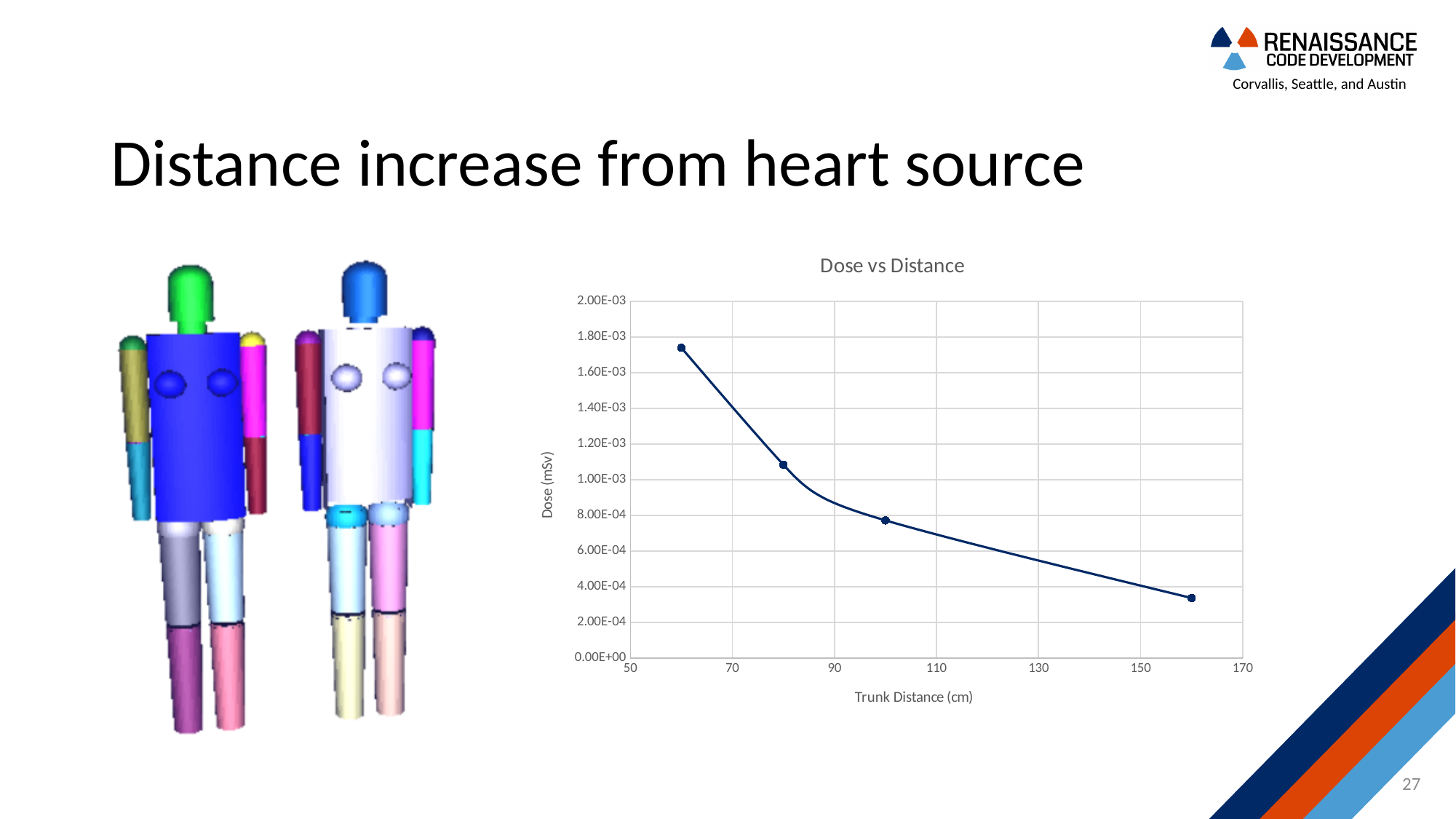
On the Dose vs Distance chart, which data point has the highest dose, the leftmost or the rightmost? the leftmost On the Dose vs Distance chart, is the dose of the leftmost data point greater or less than 2.00E-03? less On the Dose vs Distance chart, is the dose of the third data point from the left greater or less than 1.00E-03? less On the Dose vs Distance chart, is the dose of the rightmost data point greater or less than 4.00E-04? less What is the title of the chart on the slide? Dose vs Distance Does the dose rise or fall as trunk distance increases along the x axis of the Dose vs Distance chart? fall How many data points are plotted on the Dose vs Distance chart? 4 What kind of chart is the Dose vs Distance chart? line chart What is the label of the x axis on the Dose vs Distance chart? Trunk Distance (cm)